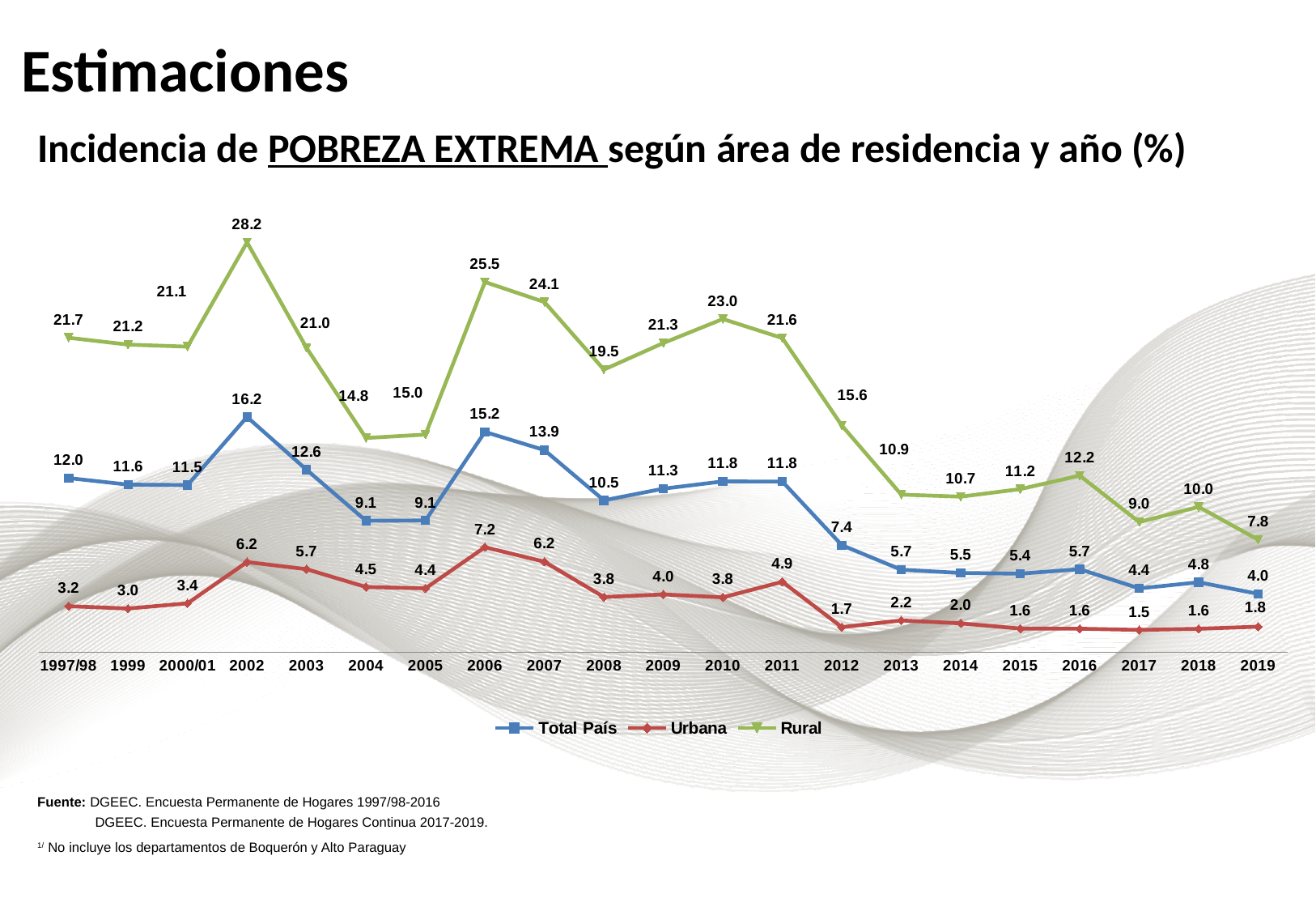
How many series does the legend list? 3 What is the Rural value for 2002? 28.2 In which year is the Urbana series at its lowest value? 2017 What kind of chart is this? Line chart What is the difference between the Total País values in 1997/98 and 2019? 8.0 How many years (categories) are shown on the x axis? 21 What is the Total País value for 2019? 4.0 In which year does the Rural series reach its highest value? 2002 Which is larger, the Rural value in 2006 or the Rural value in 2007? 2006 What is the difference between the Rural and Urbana values in 2002? 22.0 What is the Urbana value for 2006? 7.2 Does the Total País series overall rise or fall from 2011 to 2019? Fall